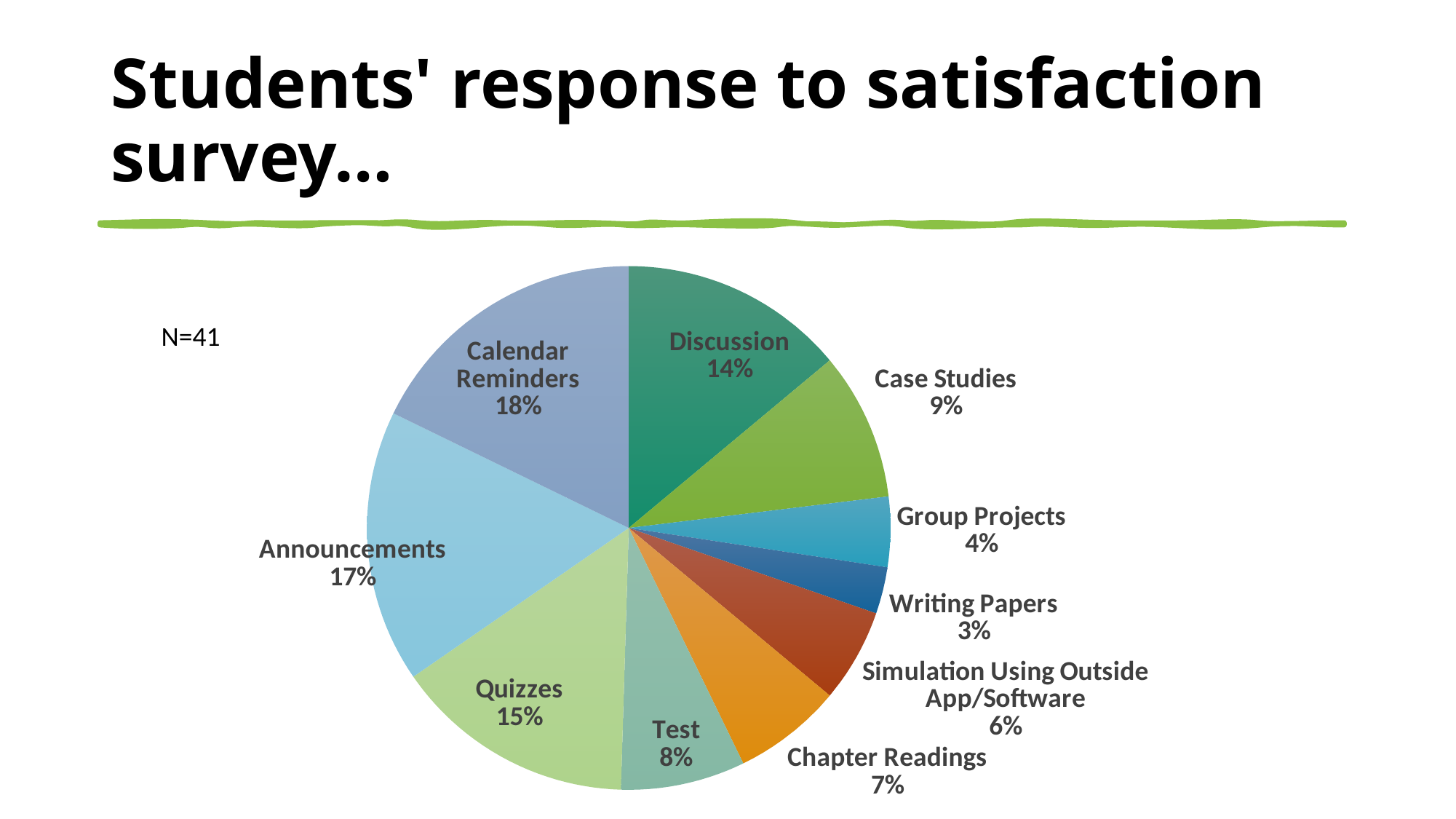
What sample size (N) is noted on the slide? N=41 What is the title of the slide containing the chart? Students' response to satisfaction survey... Which category has the largest slice of the pie? Calendar Reminders What percentage is shown for Simulation Using Outside App/Software? 6% Which category has the smallest slice of the pie? Writing Papers What is the value for Group Projects? 4% What is the difference in percentage points between Announcements and Quizzes? 2 What percentage of the pie is Calendar Reminders? 18% What is the difference in percentage points between Test and Chapter Readings? 1 What kind of chart is shown on the slide? pie chart How many categories are shown in the pie chart? 10 Which is larger, Discussion or Case Studies? Discussion